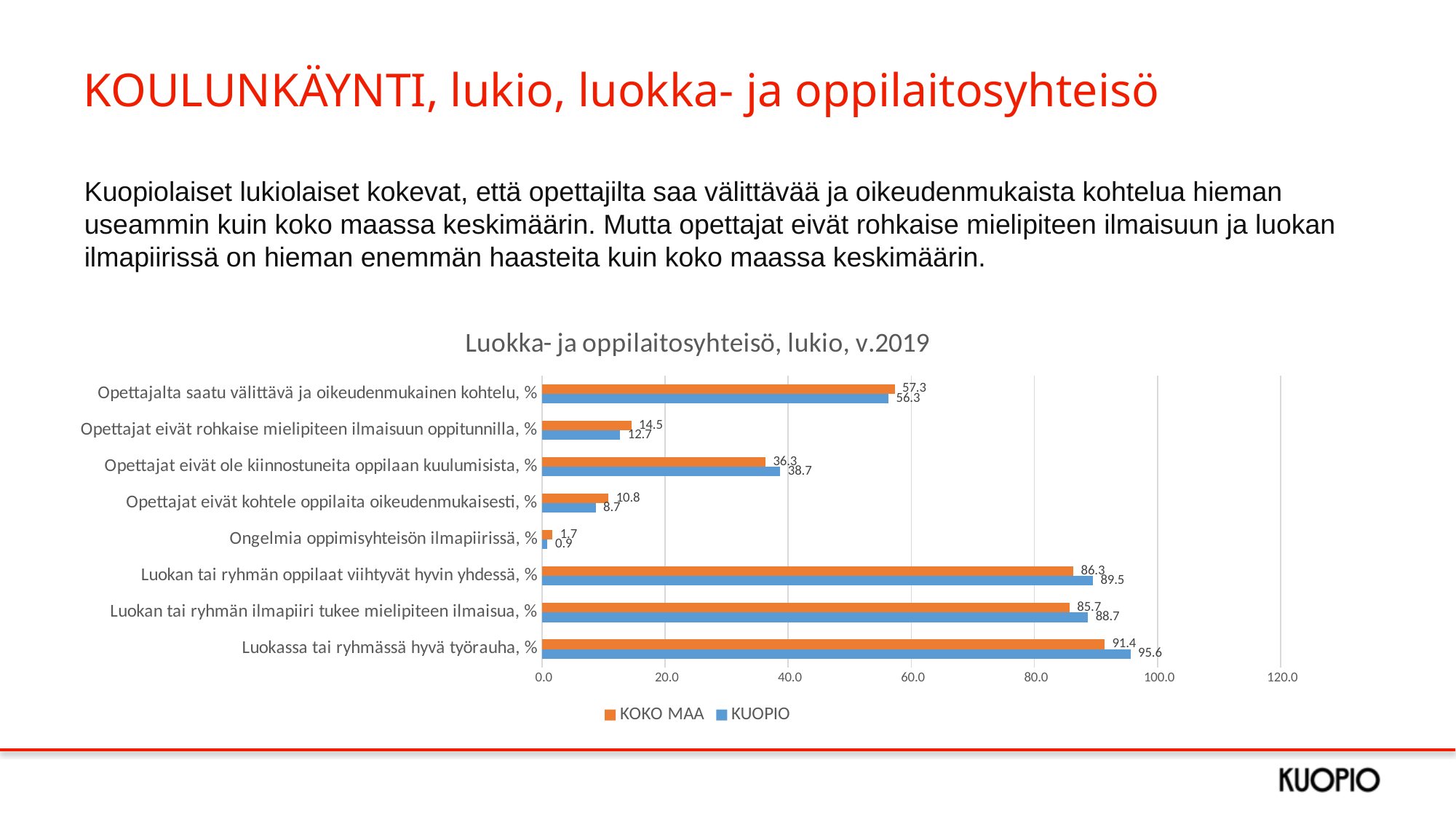
What is the KUOPIO value for "Luokassa tai ryhmässä hyvä työrauha, %"? 95.6 What is the title of the chart? Luokka- ja oppilaitosyhteisö, lukio, v.2019 How many series does the legend list? 2 Which category has the highest KUOPIO value? Luokassa tai ryhmässä hyvä työrauha, % What kind of chart is shown on the slide? Bar chart What is the KUOPIO value for "Opettajat eivät ole kiinnostuneita oppilaan kuulumisista, %"? 38.7 How many categories are shown on the chart? 8 What is the difference between the KUOPIO and KOKO MAA values for "Luokassa tai ryhmässä hyvä työrauha, %"? 4.2 Is the KOKO MAA value for "Luokan tai ryhmän oppilaat viihtyvät hyvin yhdessä, %" greater or less than 80.0? greater Which category has the lowest KOKO MAA value? Ongelmia oppimisyhteisön ilmapiirissä, % For "Opettajat eivät kohtele oppilaita oikeudenmukaisesti, %", which series has the larger value, KOKO MAA or KUOPIO? KOKO MAA What is the KOKO MAA value for "Opettajat eivät rohkaise mielipiteen ilmaisuun oppitunnilla, %"? 14.5